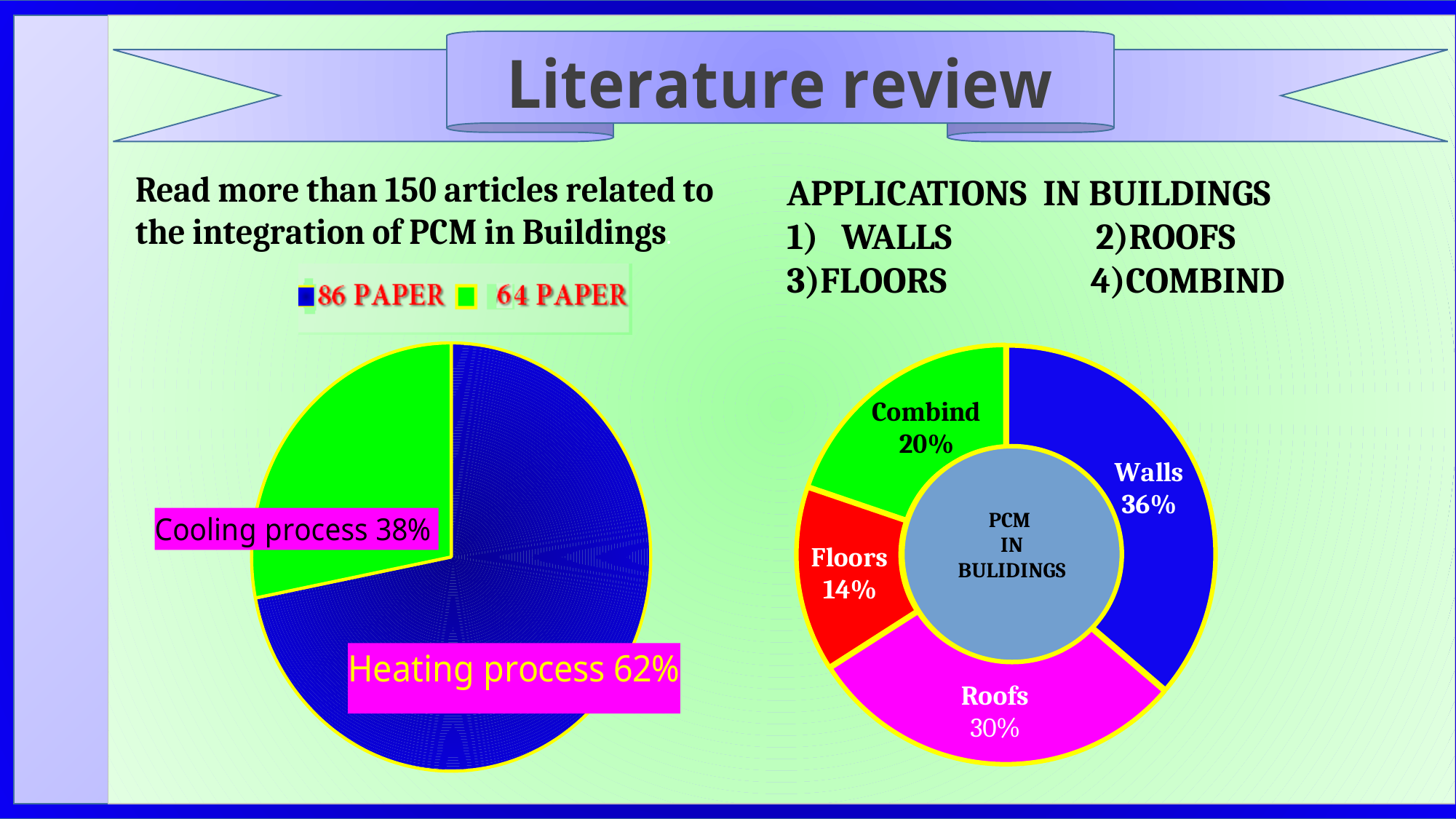
On the left pie chart, what percentage is labelled for the Cooling process? 38% On the right doughnut chart (PCM in Buildings), which application has the smallest share? Floors On the right doughnut chart (PCM in Buildings), what percentage is shown for Walls? 36% On the left pie chart, how many papers does the legend list for the blue slice? 86 PAPER On the left pie chart, which process has the larger share, Heating or Cooling? Heating process On the right doughnut chart (PCM in Buildings), what is the difference in percentage points between Roofs and Combind? 10 On the left pie chart, what is the difference in percentage points between the Heating process and the Cooling process? 24 What kind of chart is the left chart? pie chart On the right doughnut chart (PCM in Buildings), which application has the largest share? Walls On the right doughnut chart (PCM in Buildings), how many application categories are shown? 4 On the left pie chart, what percentage is labelled for the Heating process? 62% On the right doughnut chart (PCM in Buildings), what percentage is shown for Floors? 14%